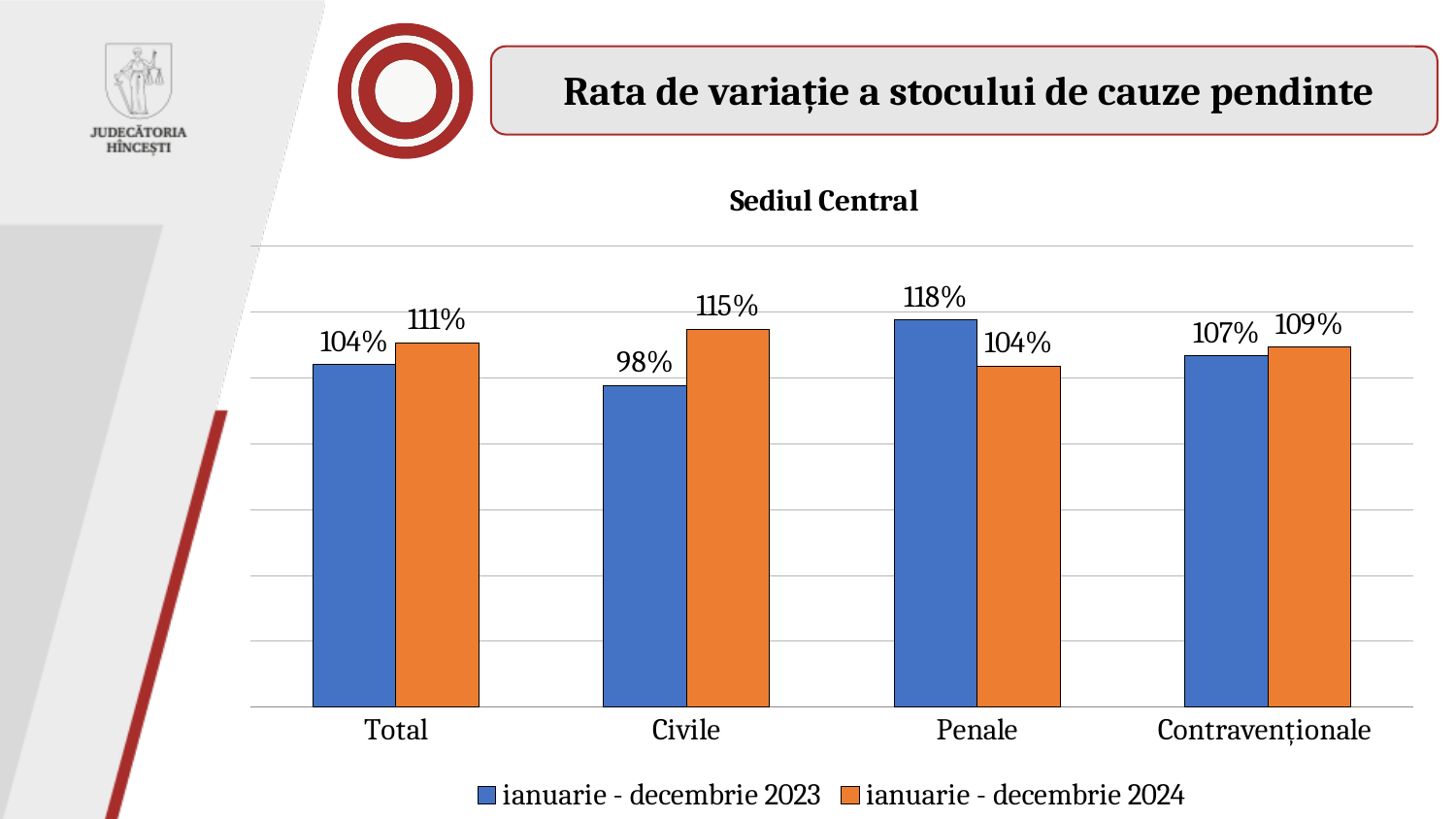
Which category has the highest value in the ianuarie - decembrie 2023 series? Penale Which category has the lowest value in the ianuarie - decembrie 2023 series? Civile What kind of chart is shown on the slide? Bar chart How many categories are shown on the x axis? 4 What is the value for Penale in the ianuarie - decembrie 2023 series? 118% Which is larger for Penale: the ianuarie - decembrie 2023 value or the ianuarie - decembrie 2024 value? ianuarie - decembrie 2023 What is the value for Total in the ianuarie - decembrie 2023 series? 104% Which category has the highest value in the ianuarie - decembrie 2024 series? Civile How many series does the legend list? 2 What is the value for Civile in the ianuarie - decembrie 2024 series? 115% What is the title of the chart? Sediul Central What is the difference between the ianuarie - decembrie 2024 and ianuarie - decembrie 2023 values for Civile? 17%